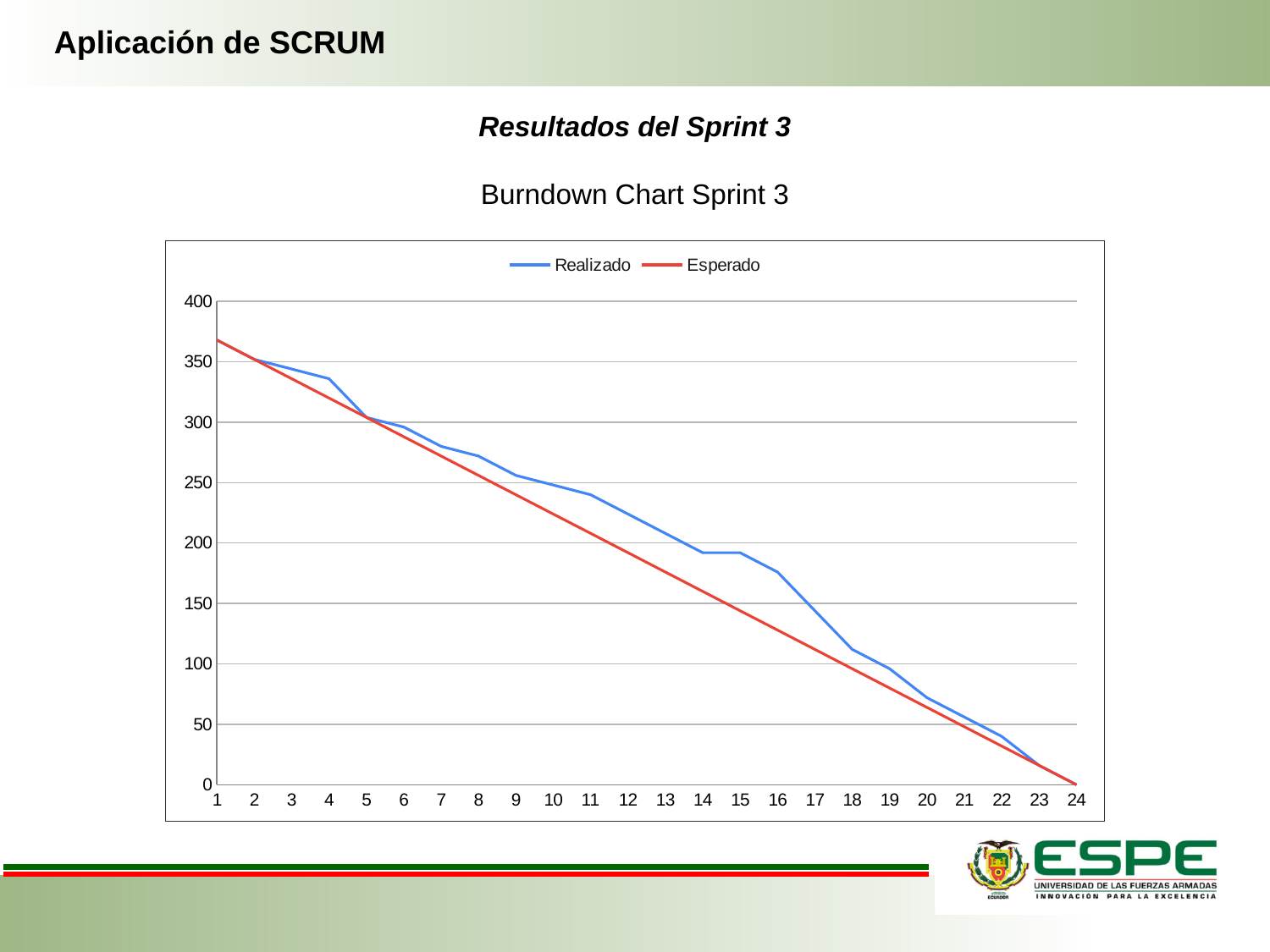
How many points are on the x axis? 24 At which x-axis point is the Realizado series at its highest? 1 Is the value of Realizado at point 22 greater or less than 50? less What kind of chart is shown on the slide? line chart What is the value of the Esperado series at point 24? 0 What is the title of the chart? Burndown Chart Sprint 3 Is the value of Realizado at point 4 greater or less than 300? greater What are the two series named in the legend? Realizado and Esperado How many series does the legend list? 2 At which x-axis point is the Realizado series at its lowest? 24 Do the values of the Realizado series rise or fall along the x axis? fall At point 15, which series has the larger value, Realizado or Esperado? Realizado